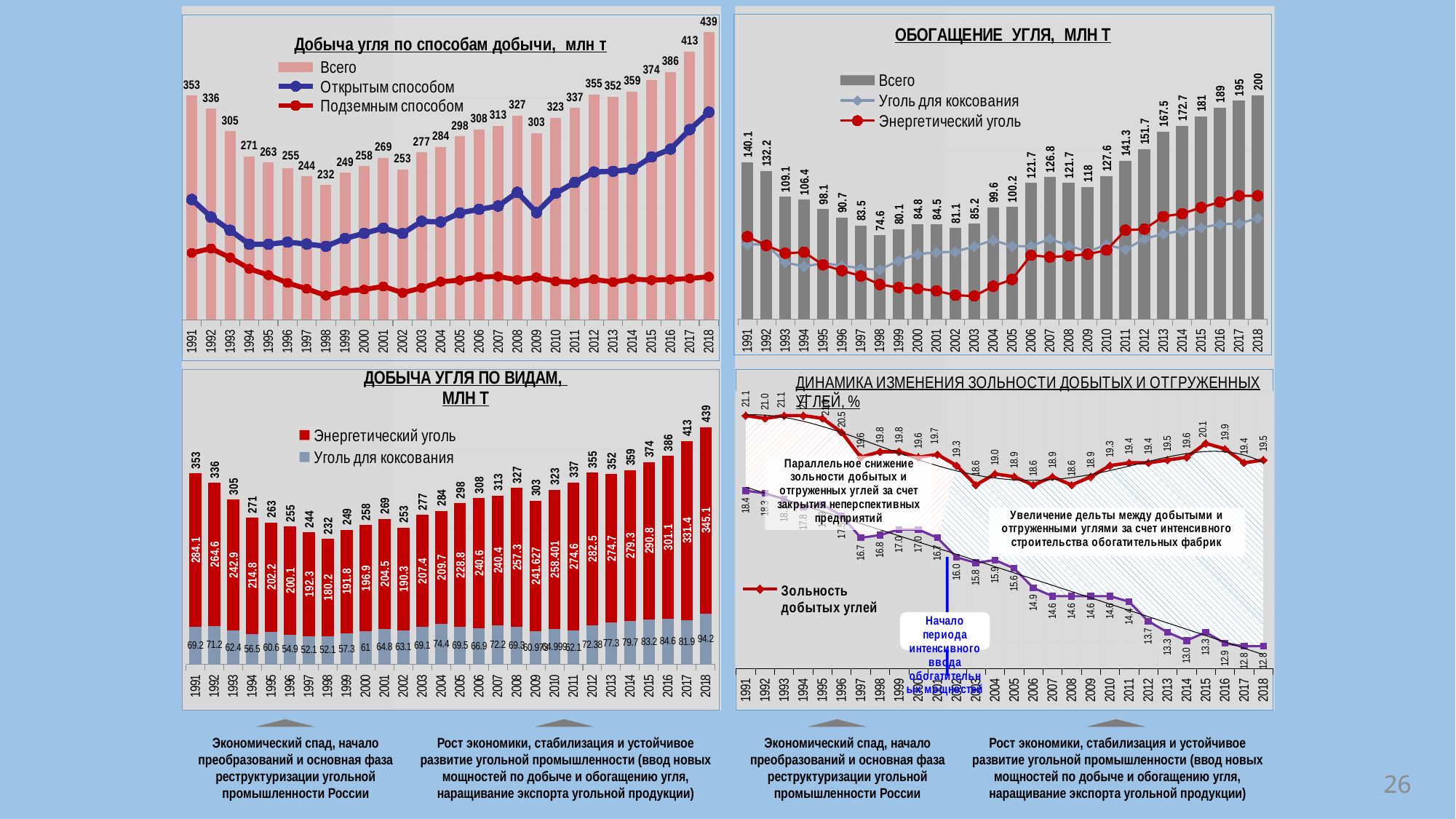
In the chart 'ОБОГАЩЕНИЕ УГЛЯ, МЛН Т', how many series does the legend list? 3 In the chart 'ОБОГАЩЕНИЕ УГЛЯ, МЛН Т', what is the 'Всего' value for 1991? 140.1 In the chart 'ДИНАМИКА ИЗМЕНЕНИЯ ЗОЛЬНОСТИ ДОБЫТЫХ И ОТГРУЖЕННЫХ УГЛЕЙ, %', does the lower (purple) line rise or fall from 1991 to 2018? fall In the chart 'Добыча угля по способам добычи, млн т', what is the value of 'Всего' for 2018? 439 In the chart 'ДОБЫЧА УГЛЯ ПО ВИДАМ, МЛН Т', what is the value of 'Уголь для коксования' for 2018? 94.2 In the chart 'Добыча угля по способам добычи, млн т', which year has the larger 'Всего' value, 2016 or 2017? 2017 In the chart 'Добыча угля по способам добычи, млн т', what is the difference between the 'Всего' values for 2018 and 1991? 86 In the chart 'ДОБЫЧА УГЛЯ ПО ВИДАМ, МЛН Т', what is the total of the stacked bar for 1991? 353 In the chart 'Добыча угля по способам добычи, млн т', which year has the lowest 'Всего' value? 1998 In the chart 'ДИНАМИКА ИЗМЕНЕНИЯ ЗОЛЬНОСТИ ДОБЫТЫХ И ОТГРУЖЕННЫХ УГЛЕЙ, %', what is the value of 'Зольность добытых углей' for 1991? 21.1 In the chart 'ДОБЫЧА УГЛЯ ПО ВИДАМ, МЛН Т', what is the value of 'Энергетический уголь' for 2018? 345.1 In the chart 'ОБОГАЩЕНИЕ УГЛЯ, МЛН Т', which year has the lowest 'Всего' value? 1998